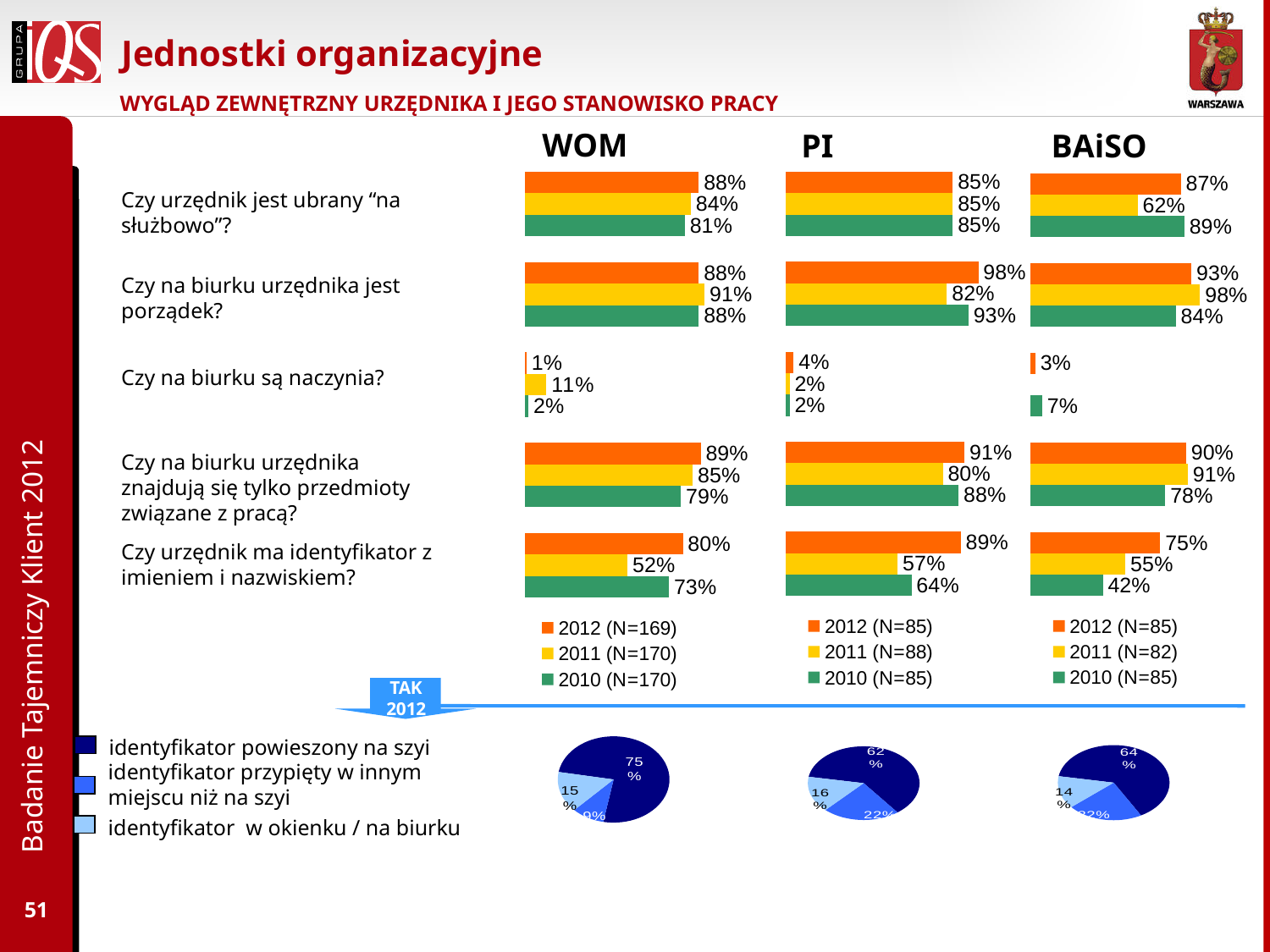
In the BAiSO bar chart, what is the 2010 value for "Czy urzędnik ma identyfikator z imieniem i nazwiskiem?"? 42% In the BAiSO bar chart, is the 2012 value for "Czy urzędnik jest ubrany na służbowo?" larger or smaller than the 2011 value? larger In the PI bar chart, what is the difference between the 2012 and 2011 values for "Czy urzędnik ma identyfikator z imieniem i nazwiskiem?"? 32% In the BAiSO bar chart, which year has the highest value for "Czy na biurku urzędnika jest porządek?"? 2011 What kind of chart is used for the WOM, PI and BAiSO data in the upper part of the slide? bar chart In the WOM bar chart, what is the 2012 value for "Czy urzędnik ma identyfikator z imieniem i nazwiskiem?"? 80% In the WOM bar chart, which year has the lowest value for "Czy urzędnik ma identyfikator z imieniem i nazwiskiem?"? 2011 In the PI bar chart, what is the 2011 value for "Czy na biurku urzędnika jest porządek?"? 82% What sample size (N) does the WOM chart legend give for 2012? N=169 How many series does the legend of the WOM bar chart list? 3 In the PI pie chart at the bottom of the slide, what is the largest slice's value? 62% In the WOM bar chart, what is the 2011 value for "Czy na biurku są naczynia?"? 11%